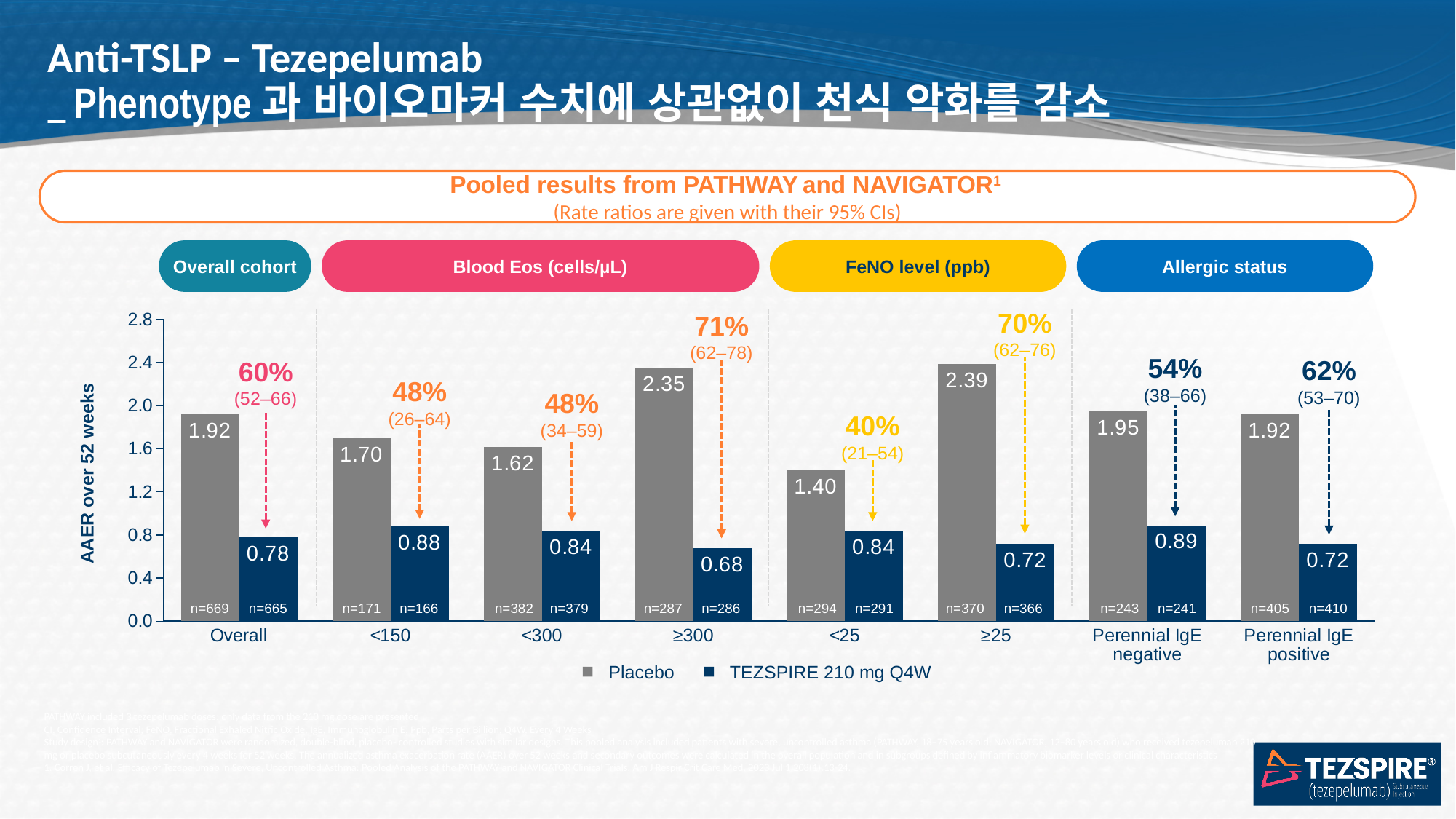
Which category has the lowest TEZSPIRE 210 mg Q4W value? ≥300 How many categories are shown on the x axis of the chart? 8 Which is larger for the Perennial IgE positive category, the Placebo value or the TEZSPIRE 210 mg Q4W value? Placebo What kind of chart is shown on the slide? bar chart What is the Placebo value for the <25 FeNO level category? 1.40 What is the difference between the Placebo and TEZSPIRE 210 mg Q4W values for the Overall category? 1.14 How many series does the legend list? 2 Which category has the highest Placebo value? ≥25 What is the label of the y axis of the chart? AAER over 52 weeks What is the TEZSPIRE 210 mg Q4W value for the ≥300 Blood Eos category? 0.68 Is the Placebo value for the ≥300 category greater or less than 2.0? greater What is the Placebo value for the Overall category? 1.92